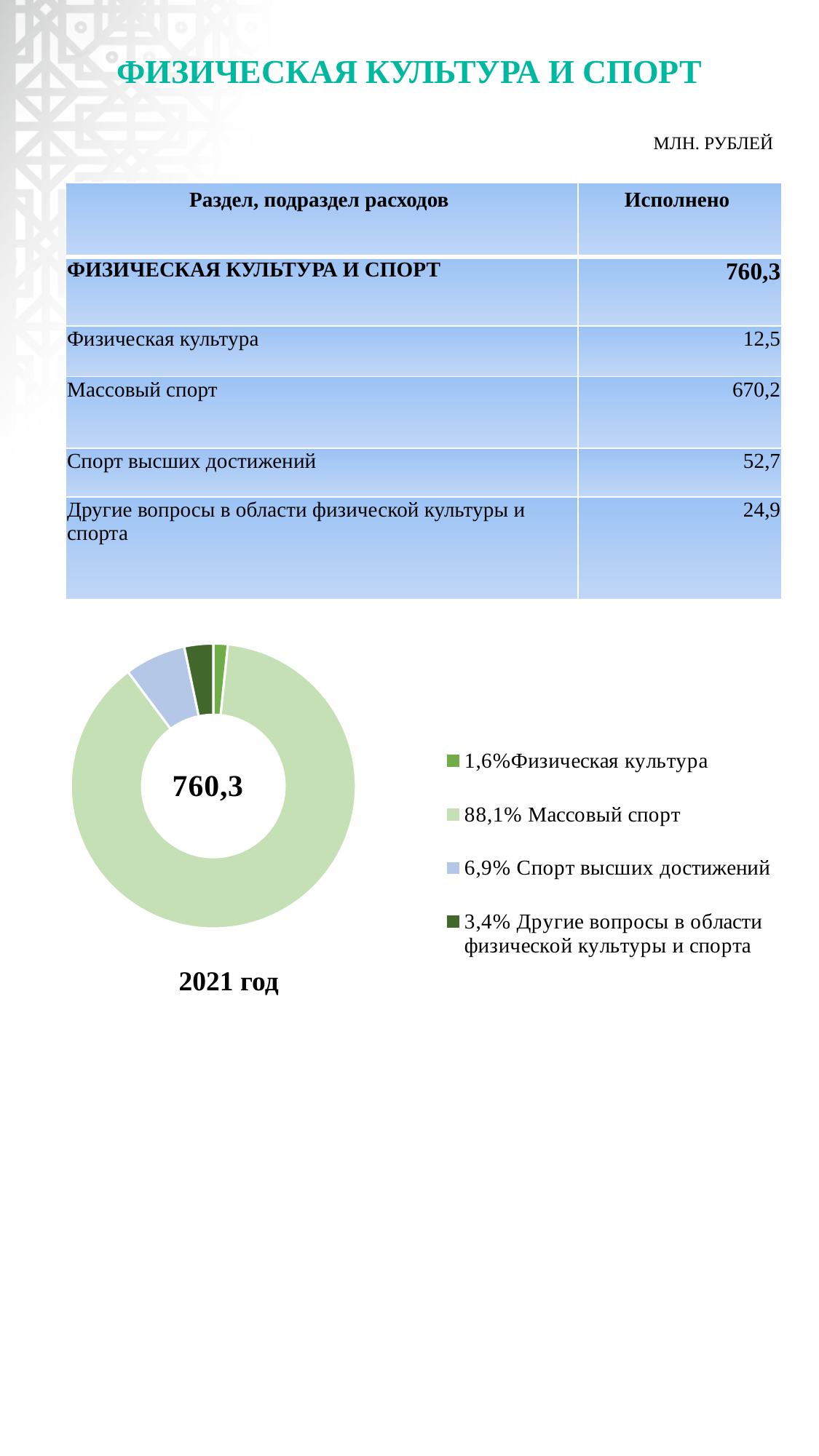
What share of the donut chart does Спорт высших достижений take? 6,9% What share of the donut chart does Массовый спорт take? 88,1% Which category has the smallest slice in the donut chart? Физическая культура What kind of chart is shown on the slide? pie chart (donut) What total value is printed in the centre of the donut chart? 760,3 What share of the donut chart does Другие вопросы в области физической культуры и спорта take? 3,4% Which category has the largest slice in the donut chart? Массовый спорт What is the difference in percentage points between the Массовый спорт slice and the Спорт высших достижений slice? 81,2 How many slices does the donut chart have? 4 What year is labelled below the donut chart? 2021 год Which slice is larger in the donut chart: Спорт высших достижений or Другие вопросы в области физической культуры и спорта? Спорт высших достижений